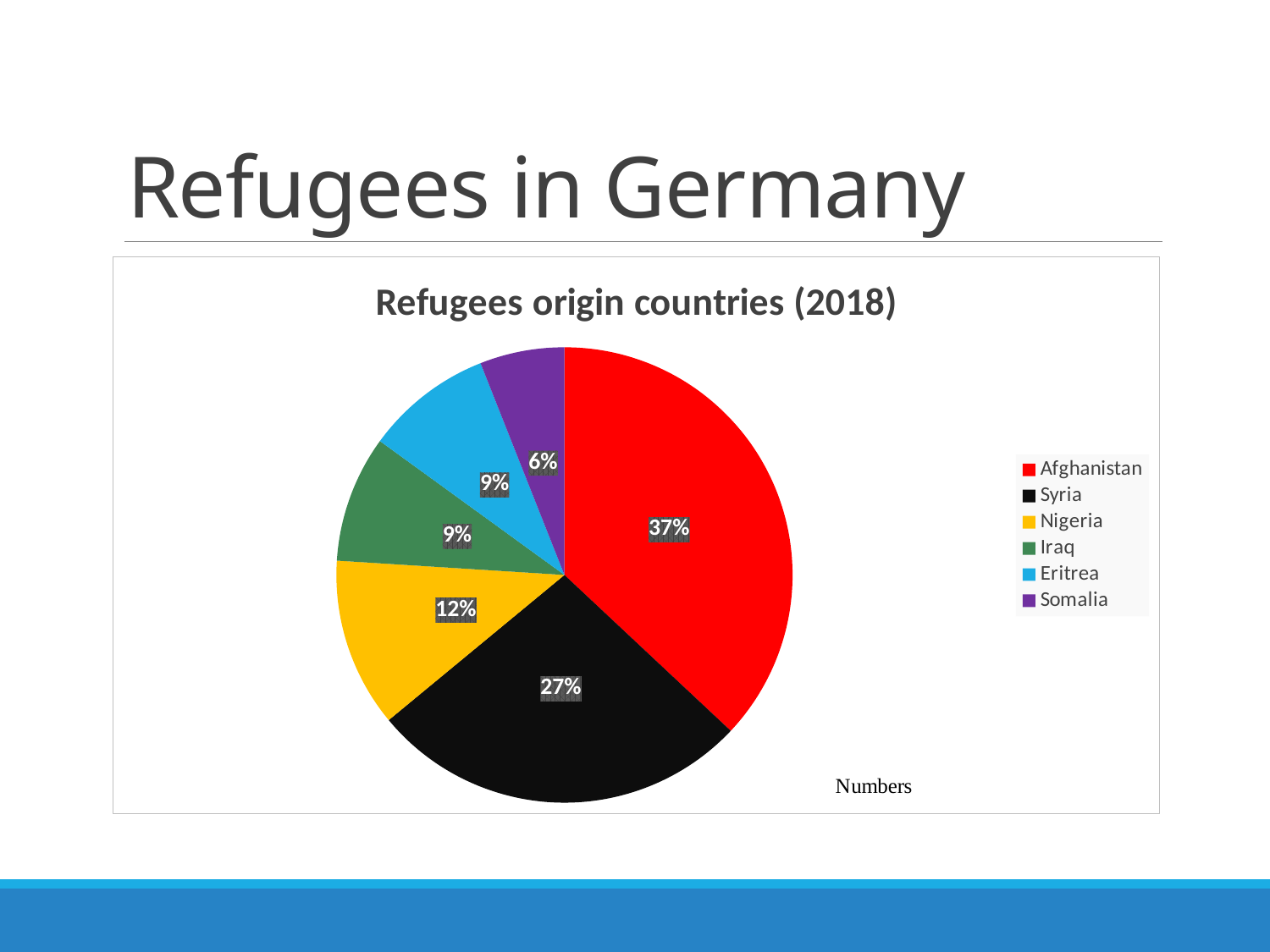
What percentage of the pie does Syria represent? 27% How many countries are shown in the pie chart? 6 What type of chart is shown on the slide? pie chart What percentage of the pie does Afghanistan represent? 37% What percentage of the pie does Nigeria represent? 12% What is the title of the chart? Refugees origin countries (2018) Which country has the largest slice of the pie? Afghanistan What is the difference in percentage points between Afghanistan and Syria? 10 Which colour represents Eritrea in the chart? light blue Which is larger, the share for Nigeria or the share for Somalia? Nigeria Which country has the smallest slice of the pie? Somalia What percentage of the pie does Somalia represent? 6%